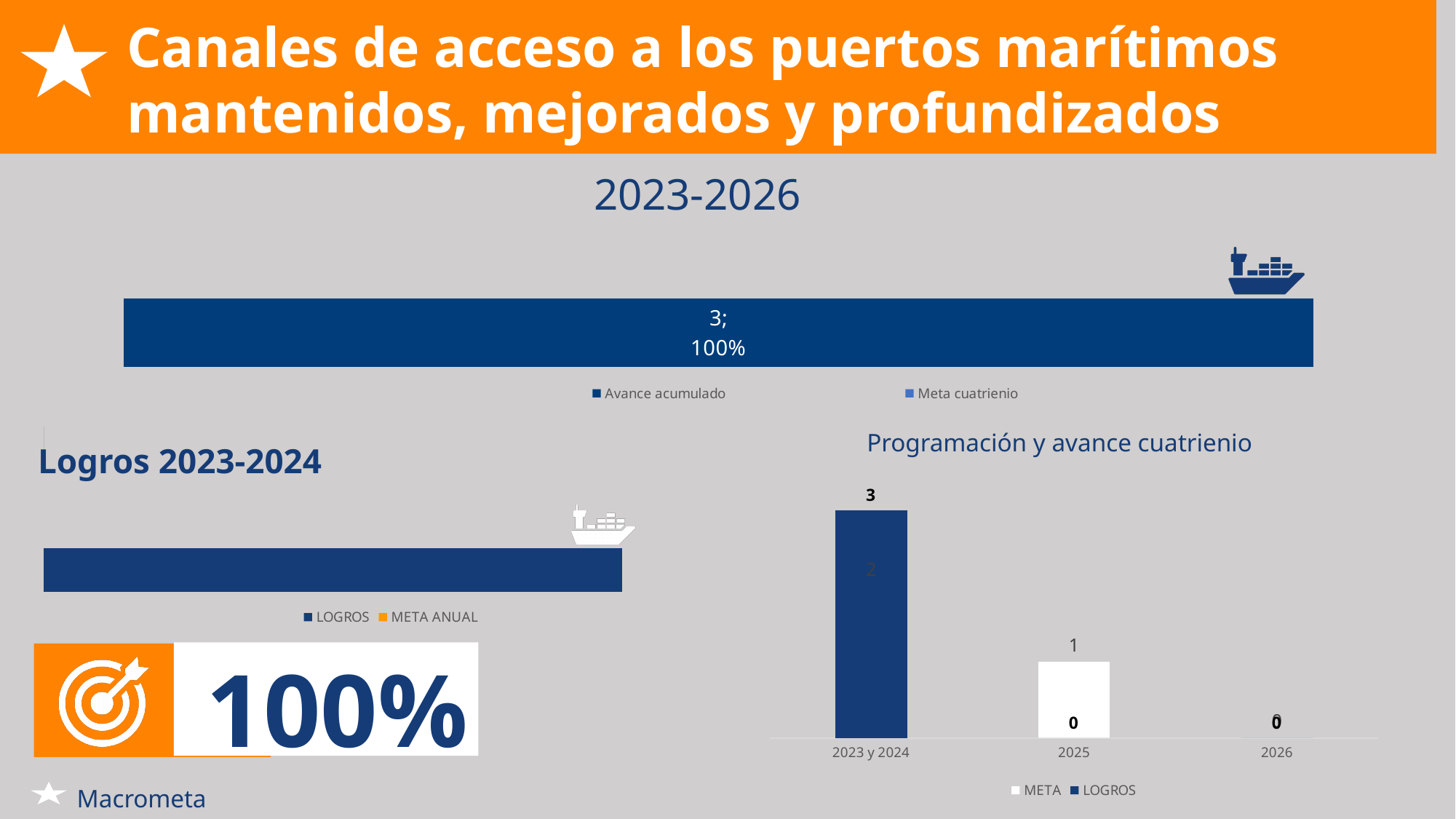
In the 'Programación y avance cuatrienio' chart, which is larger: the LOGROS value for 2023 y 2024 or the META value for 2025? LOGROS for 2023 y 2024 In the 'Programación y avance cuatrienio' chart, which category has the highest LOGROS value? 2023 y 2024 In the 'Programación y avance cuatrienio' chart, what is the LOGROS value for 2023 y 2024? 3 In the 'Programación y avance cuatrienio' chart, what is the META value for 2025? 1 In the 'Programación y avance cuatrienio' chart, what is the difference between the LOGROS value for 2023 y 2024 and the META value for 2025? 2 How many series does the legend of the 'Programación y avance cuatrienio' chart list? 2 What kind of chart is the 'Programación y avance cuatrienio' chart? Bar chart In the '2023-2026' chart at the top, what value and percentage are printed on the bar? 3; 100% What are the two legend entries of the 'Logros 2023-2024' chart? LOGROS and META ANUAL In the 'Programación y avance cuatrienio' chart, what is the LOGROS value for 2025? 0 How many categories are shown on the x axis of the 'Programación y avance cuatrienio' chart? 3 What are the two legend entries of the '2023-2026' chart at the top? Avance acumulado and Meta cuatrienio